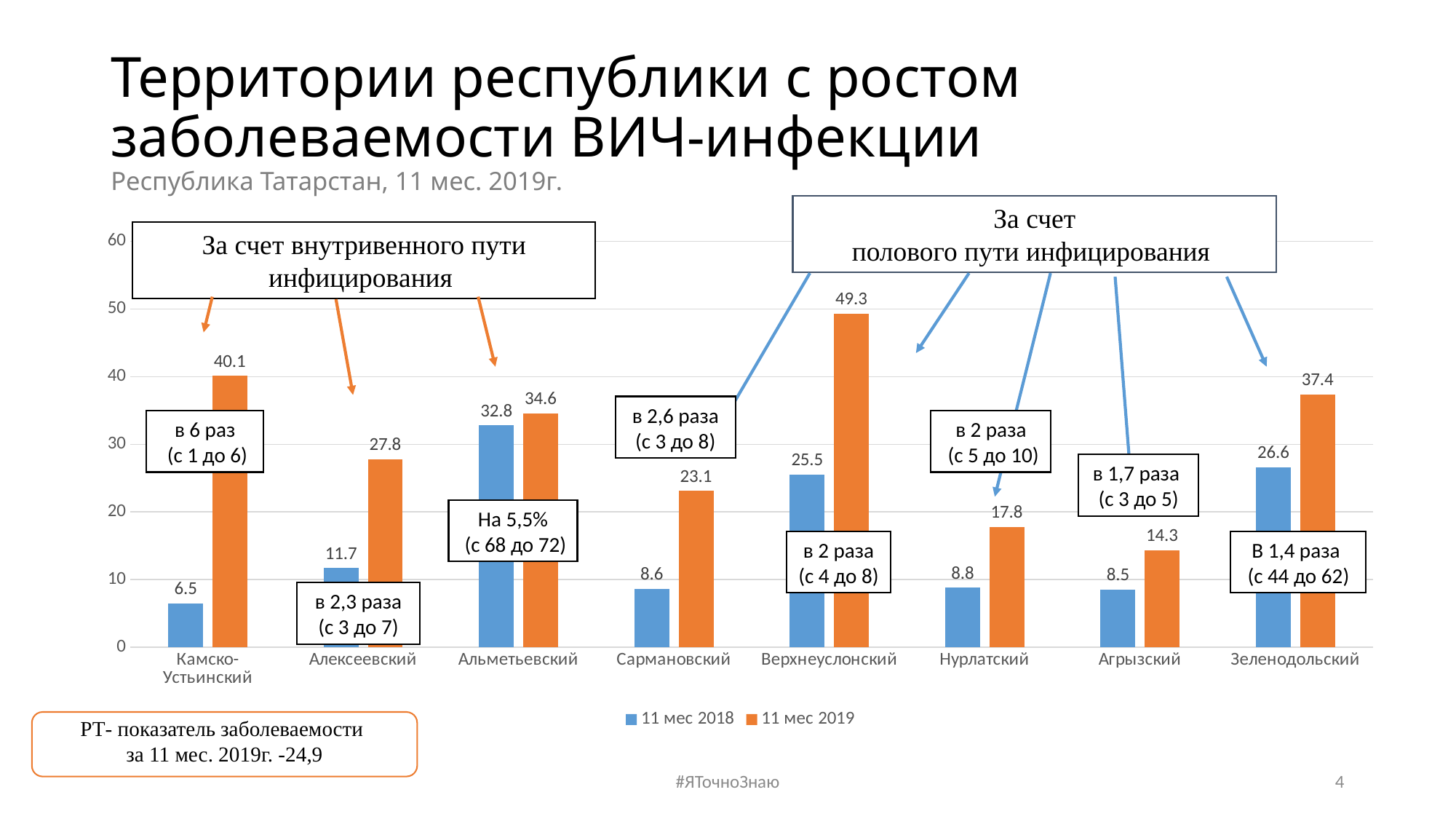
What is the value for Зеленодольский in the 11 мес 2019 series? 37.4 Which colour represents the 11 мес 2019 series in the legend? Orange How many series does the legend list? 2 Which category has the lowest value in the 11 мес 2018 series? Камско-Устьинский What is the value for Камско-Устьинский in the 11 мес 2018 series? 6.5 Which is larger: the 11 мес 2018 value for Альметьевский or the 11 мес 2018 value for Зеленодольский? Альметьевский What is the difference between the 11 мес 2019 and 11 мес 2018 values for Камско-Устьинский? 33.6 Is the 11 мес 2019 value for Сармановский greater or less than 20? greater What kind of chart is shown on the slide? Bar chart What is the value for Верхнеуслонский in the 11 мес 2019 series? 49.3 How many categories (territories) are shown on the x axis? 8 Which category has the highest value in the 11 мес 2019 series? Верхнеуслонский